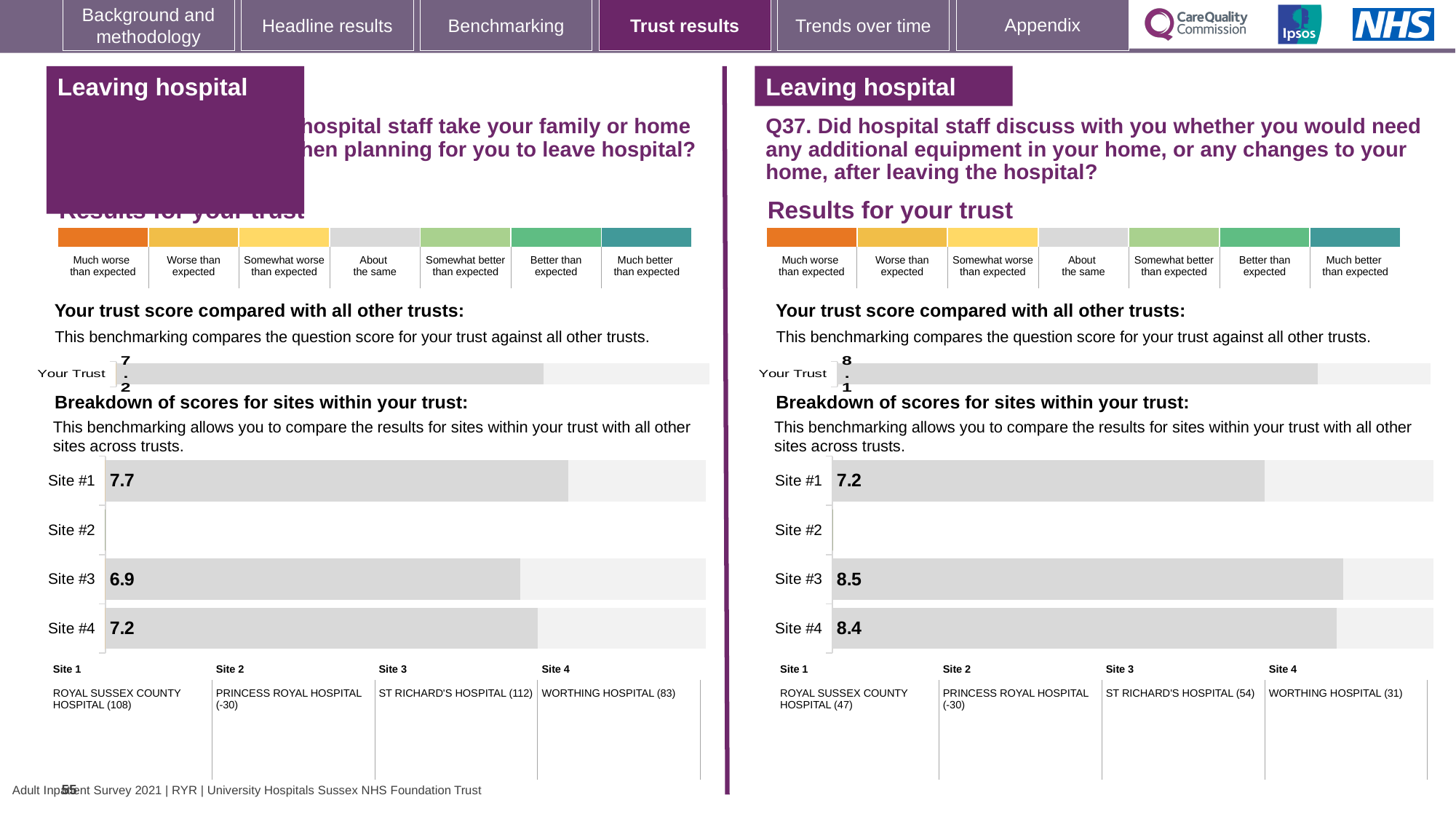
On the left-hand chart, what is the score shown for Your Trust? 7.2 On the right-hand chart (Q37), which site has the highest score? Site #3 On the right-hand chart (Q37), what is the score for Site #3? 8.5 What kind of chart is used to show the breakdown of scores for sites within the trust? Bar chart On the left-hand chart, which has the higher score, Site #1 or Site #4? Site #1 On the left-hand chart, what is the difference between the scores for Site #1 and Site #3? 0.8 On the right-hand chart (Q37), which has the higher score, Site #1 or Site #4? Site #4 On the left-hand chart, which site with a printed score has the lowest score? Site #3 On the left-hand chart, what is the score for Site #1? 7.7 How many sites are listed in the site breakdown on the right-hand chart (Q37)? 4 On the right-hand chart (Q37), what is the score shown for Your Trust? 8.1 On the right-hand chart (Q37), what is the difference between the scores for Site #3 and Site #1? 1.3